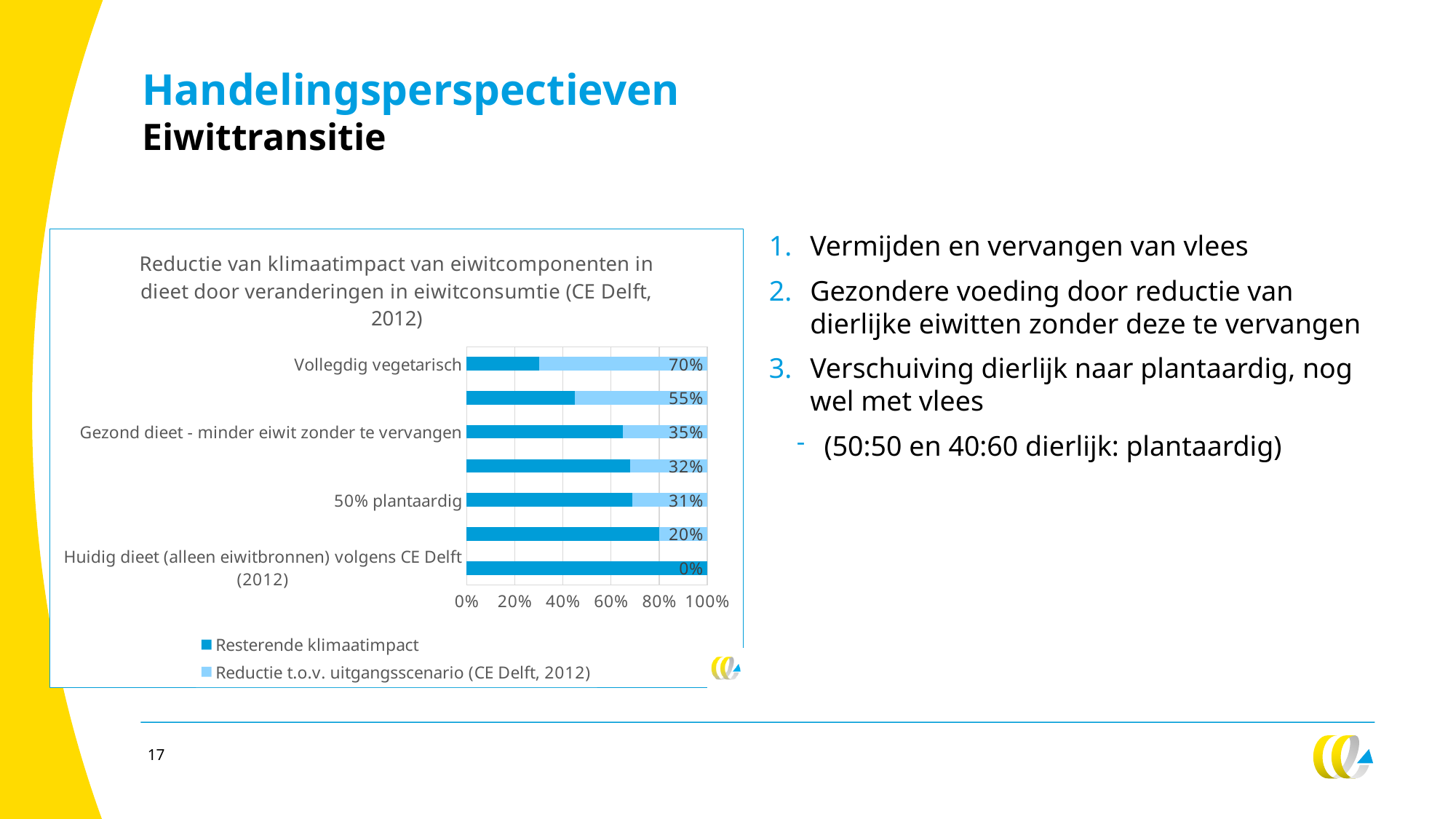
What is the 'Reductie t.o.v. uitgangsscenario' value for 'Gezond dieet - minder eiwit zonder te vervangen'? 35% How many series does the chart legend list? 2 Which labelled category has the highest 'Reductie t.o.v. uitgangsscenario' value? Vollegdig vegetarisch What is the 'Reductie t.o.v. uitgangsscenario' value for 'Huidig dieet (alleen eiwitbronnen) volgens CE Delft (2012)'? 0% Which labelled category has the lowest 'Reductie t.o.v. uitgangsscenario' value? Huidig dieet (alleen eiwitbronnen) volgens CE Delft (2012) What is the difference between the reduction values for 'Vollegdig vegetarisch' and 'Gezond dieet - minder eiwit zonder te vervangen'? 35 percentage points What type of chart is shown on the slide? Stacked bar chart Is the 'Resterende klimaatimpact' value for 'Vollegdig vegetarisch' greater or less than 40%? less What is the first legend entry of the chart? Resterende klimaatimpact What is the 'Reductie t.o.v. uitgangsscenario' value for '50% plantaardig'? 31% What is the 'Reductie t.o.v. uitgangsscenario' value for 'Vollegdig vegetarisch'? 70% How many bars are plotted in the chart? 7